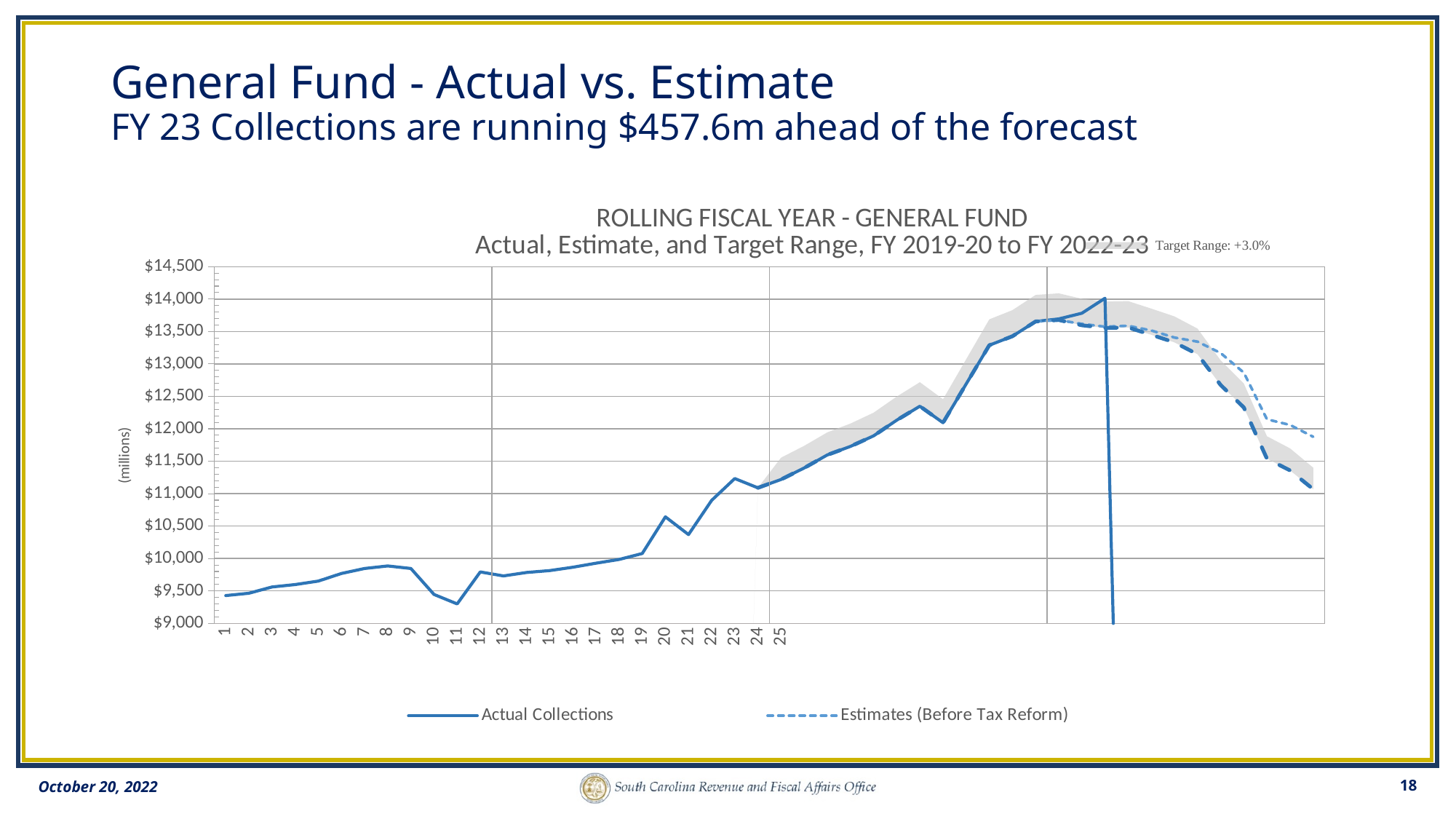
Is the Actual Collections value at point 20 greater or less than $10,500? greater Is the Actual Collections value at point 11 greater or less than $9,500? less Does the Actual Collections line rise or fall from point 12 to point 19? rise How many series does the chart legend list? 2 Is the Actual Collections value at point 21 greater or less than $10,500? less Does the Actual Collections line rise or fall from point 9 to point 11? fall What is the highest numbered label shown on the x axis? 25 What kind of chart is shown on the slide? line chart What target range is stated next to the chart title? +3.0% What is the name of the second series in the chart legend? Estimates (Before Tax Reform)